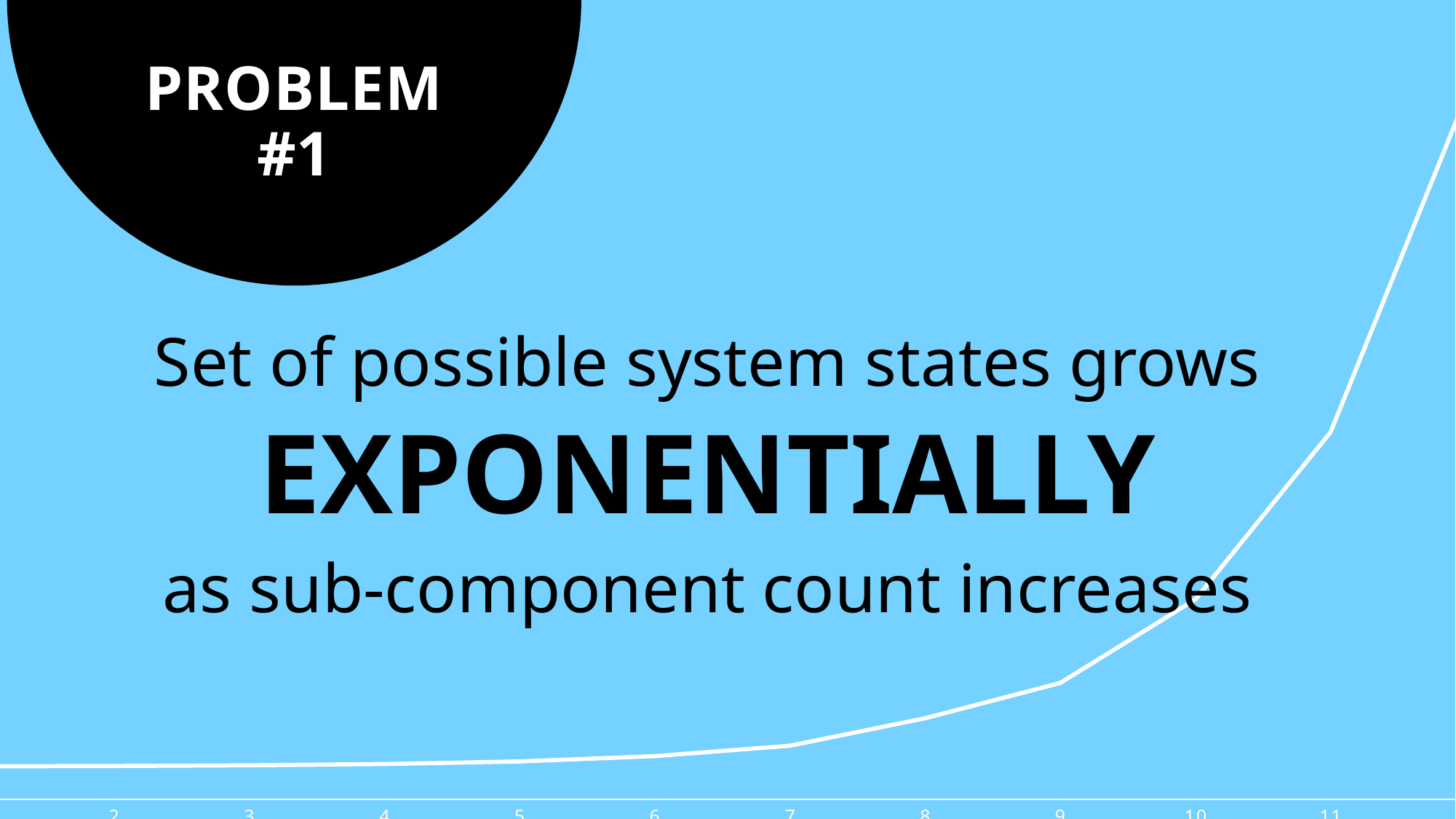
Is the value at x = 11 larger or smaller than the value at x = 2? larger What is the largest x-axis label shown on the chart? 11 What colour is the plotted line on the chart? white Does the line grow faster between x = 10 and x = 11 or between x = 2 and x = 3? between 10 and 11 Do the values on the chart rise or fall as the x axis increases from 2 to 11? rise What kind of chart is shown on the slide? line chart Is the value at x = 9 larger or smaller than the value at x = 10? smaller